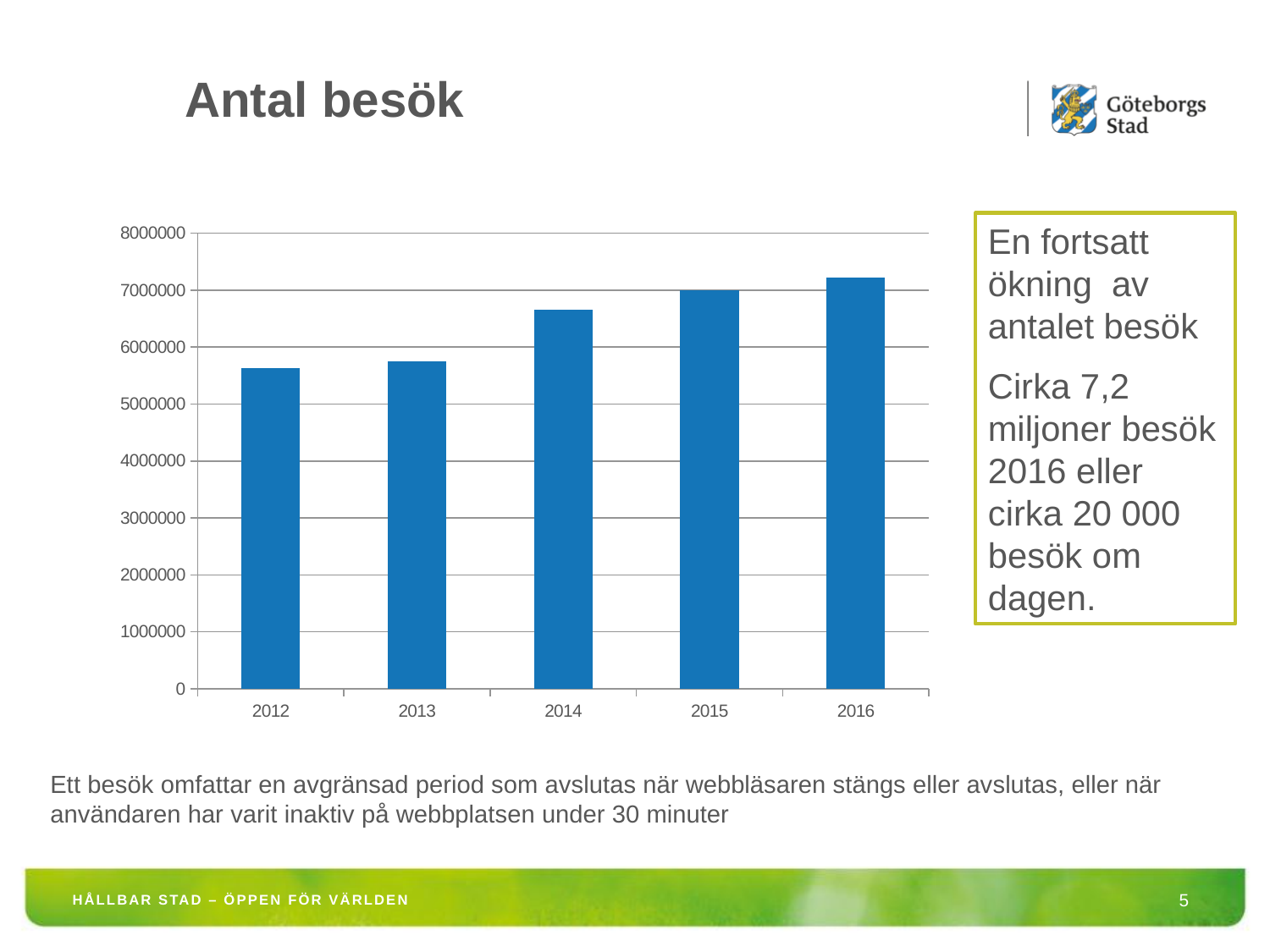
What is the title of the chart? Antal besök Which year has the highest number of visits in the chart? 2016 Which year has the lowest number of visits in the chart? 2012 Is the value for 2016 greater or less than 7000000? greater Do the values in the chart rise or fall from 2012 to 2016? rise Is the value for 2014 greater or less than 7000000? less What kind of chart is shown on the slide? bar chart Is the value for 2013 greater or less than 6000000? less How many years are shown on the x axis of the chart? 5 Which year has the larger value, 2012 or 2014? 2014